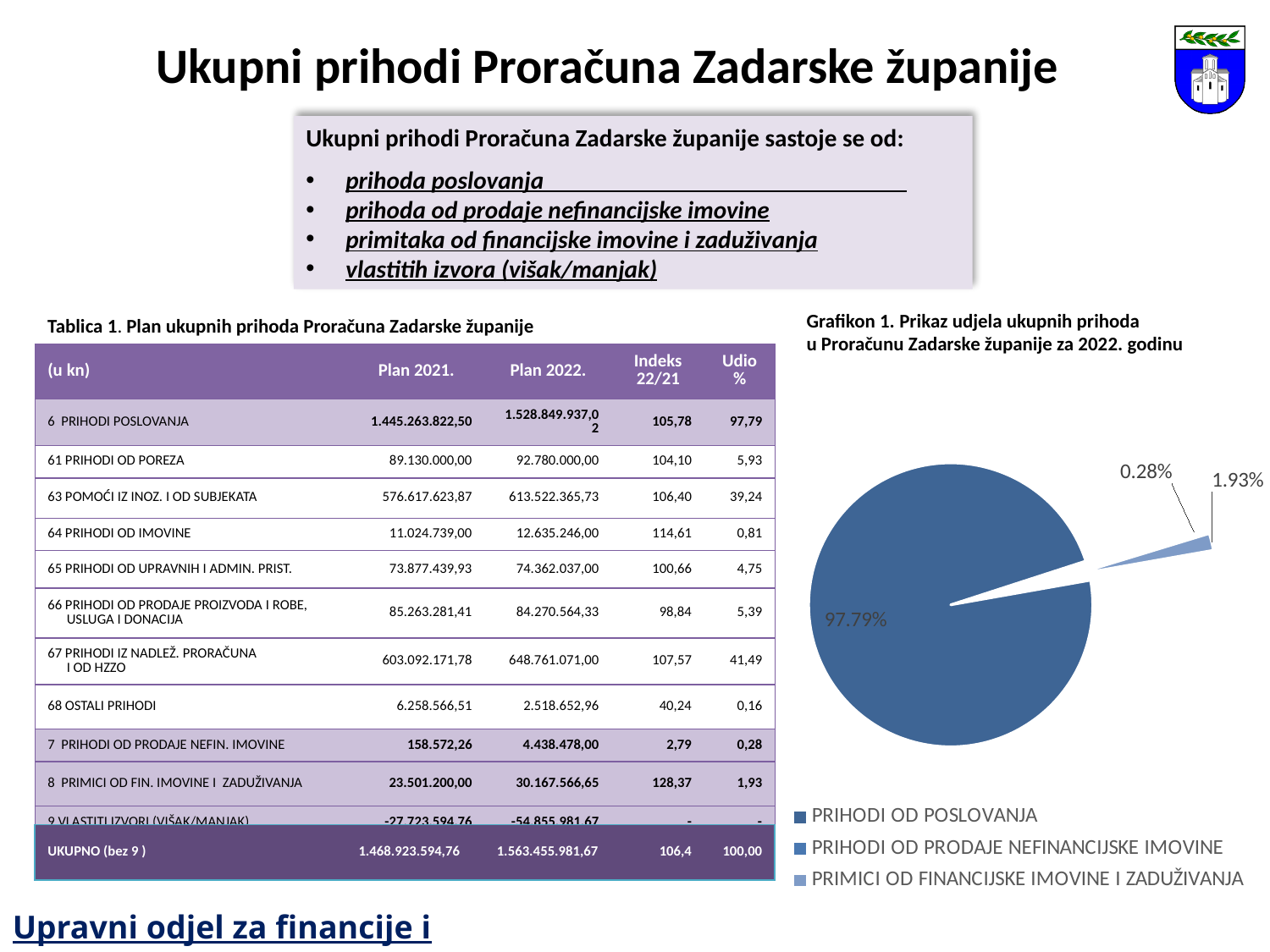
What share of the pie chart does PRIMICI OD FINANCIJSKE IMOVINE I ZADUŽIVANJA represent? 1.93% What type of chart is shown on the slide? pie chart What share of the pie chart does PRIHODI OD POSLOVANJA represent? 97.79% Which category has the smallest slice in the pie chart? PRIHODI OD PRODAJE NEFINANCIJSKE IMOVINE Which category has the largest slice in the pie chart? PRIHODI OD POSLOVANJA What is the difference in percentage points between the PRIMICI OD FINANCIJSKE IMOVINE I ZADUŽIVANJA slice and the PRIHODI OD PRODAJE NEFINANCIJSKE IMOVINE slice? 1.65 Which is larger in the pie chart: PRIMICI OD FINANCIJSKE IMOVINE I ZADUŽIVANJA or PRIHODI OD PRODAJE NEFINANCIJSKE IMOVINE? PRIMICI OD FINANCIJSKE IMOVINE I ZADUŽIVANJA How many entries does the legend of the pie chart list? 3 What share of the pie chart does PRIHODI OD PRODAJE NEFINANCIJSKE IMOVINE represent? 0.28% Which legend entry is listed first in the pie chart's legend? PRIHODI OD POSLOVANJA How many slices does the pie chart have? 3 What is the title of the pie chart? Grafikon 1. Prikaz udjela ukupnih prihoda u Proračunu Zadarske županije za 2022. godinu